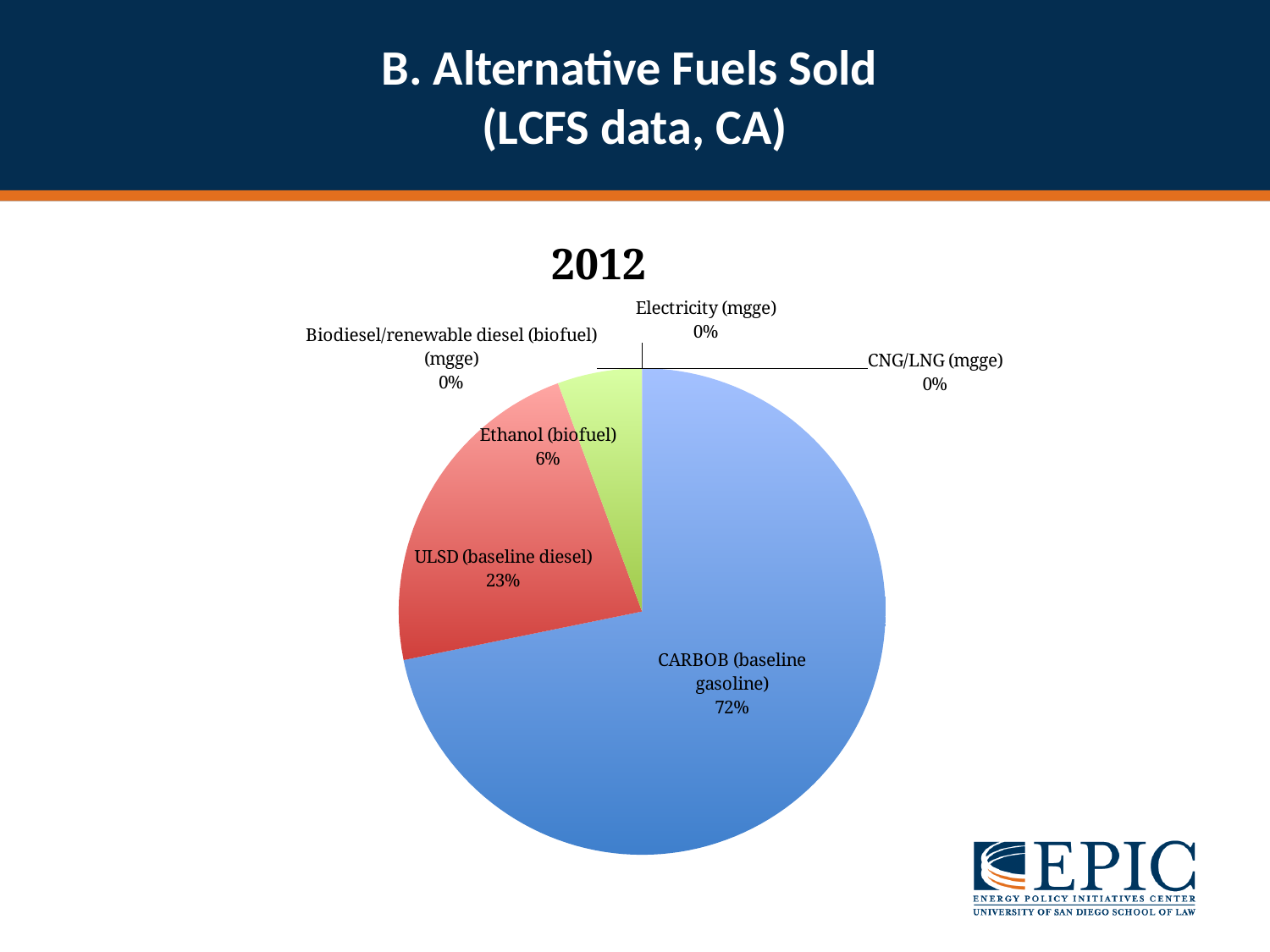
What is the chart's title? 2012 What share of the pie does CARBOB (baseline gasoline) have? 72% What percentage is shown for Electricity (mgge)? 0% What share of the pie does ULSD (baseline diesel) have? 23% What is the difference in percentage points between CARBOB (baseline gasoline) and ULSD (baseline diesel)? 49 How many categories are labelled on the pie chart? 6 What kind of chart is shown on the slide? pie chart What percentage is shown for CNG/LNG (mgge)? 0% What share of the pie does Ethanol (biofuel) have? 6% Which category has the largest slice of the pie? CARBOB (baseline gasoline) Which is larger, the share for ULSD (baseline diesel) or the share for Ethanol (biofuel)? ULSD (baseline diesel) What colour is the CARBOB (baseline gasoline) slice? blue